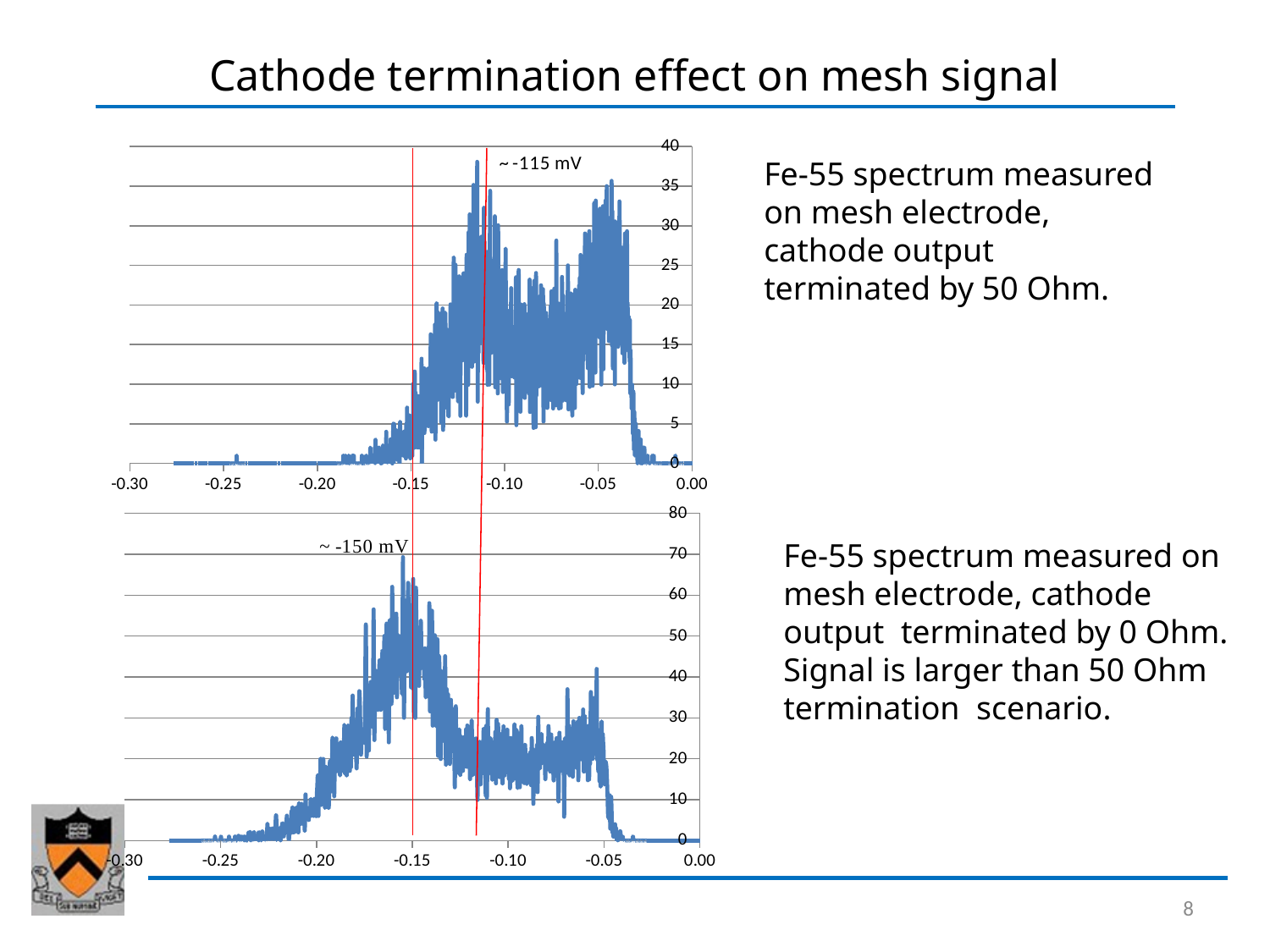
What is the maximum value shown on the y axis of the bottom chart (0 Ohm termination)? 80 In the bottom chart (0 Ohm termination), is the value at x = -0.10 greater or less than 40? less In the top chart (50 Ohm termination), is the value at x = -0.25 greater or less than 5? less In the top chart (50 Ohm termination), what value does the annotation next to the red line give? ~ -115 mV How many charts are shown on the slide? 2 In the top chart (50 Ohm termination), is the highest peak of the spectrum greater or less than 35? greater In the bottom chart (0 Ohm termination), what value does the annotation near the main peak give? ~ -150 mV What is the maximum value shown on the y axis of the top chart (50 Ohm termination)? 40 Which chart reaches a higher peak count, the top chart (50 Ohm termination) or the bottom chart (0 Ohm termination)? bottom chart (0 Ohm termination) What kind of chart is the top chart on the slide? line chart